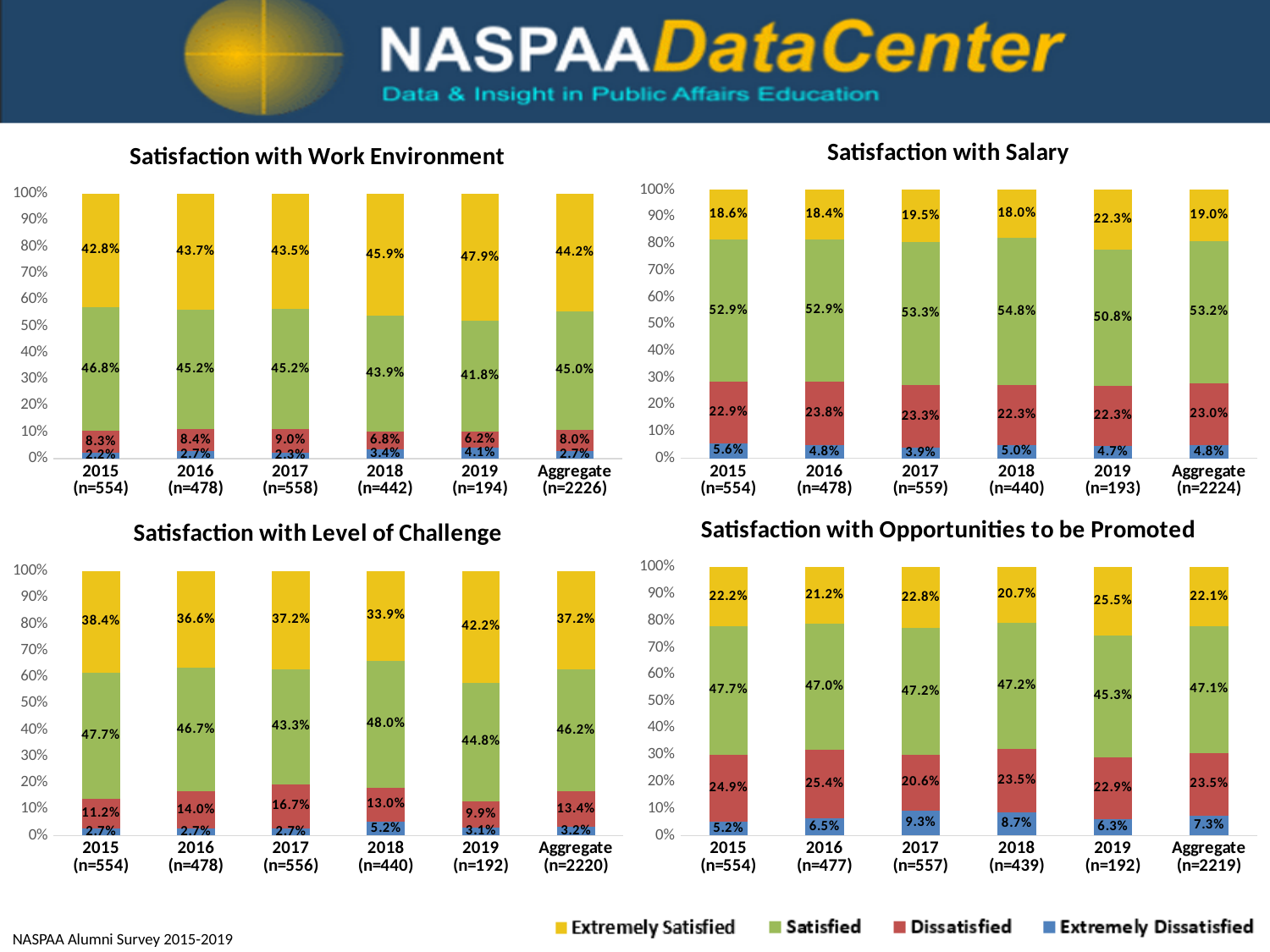
In the Satisfaction with Work Environment chart, what percentage of 2019 respondents were Extremely Satisfied? 47.9% In the Satisfaction with Opportunities to be Promoted chart, what is the difference between the Extremely Satisfied percentages for 2019 and 2018? 4.8% What type of chart is the Satisfaction with Level of Challenge chart? Stacked bar chart In the Satisfaction with Level of Challenge chart, what is the Extremely Dissatisfied percentage for 2018? 5.2% How many series does the legend at the bottom of the slide list? 4 How many bars (categories) are shown in the Satisfaction with Salary chart? 6 In the Satisfaction with Work Environment chart, which year has the highest Extremely Satisfied percentage? 2019 In the Satisfaction with Opportunities to be Promoted chart, what is the Satisfied percentage for the Aggregate bar? 47.1% In the Satisfaction with Level of Challenge chart, which year has the lowest Extremely Satisfied percentage? 2018 In the Satisfaction with Opportunities to be Promoted chart, what is the combined percentage of Satisfied and Extremely Satisfied respondents in 2015? 69.9% In the Satisfaction with Salary chart, which is larger: the Satisfied percentage for 2018 or for 2019? 2018 In the Satisfaction with Salary chart, what is the Dissatisfied percentage for 2016? 23.8%